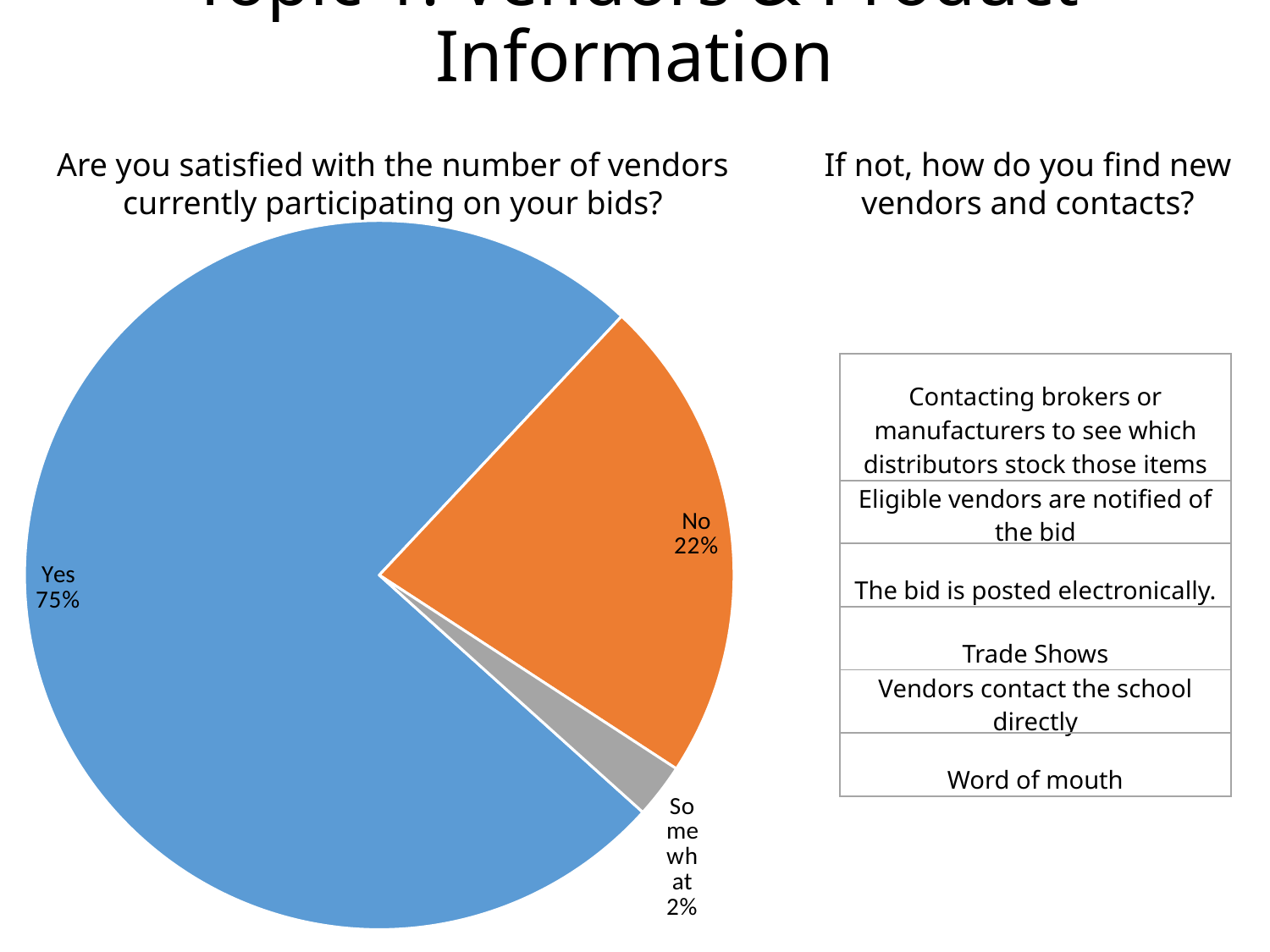
How many slices does the pie chart have? 3 What share of the pie does the "Yes" slice represent? 75% What is the difference in percentage points between the "No" and "Somewhat" slices? 20 What kind of chart is shown on the slide? pie chart What is the difference in percentage points between the "Yes" and "No" slices? 53 Which response has the largest slice of the pie? Yes What colour is the "No" slice of the pie chart? orange What share of the pie does the "No" slice represent? 22% Which response has the smallest slice of the pie? Somewhat What is the title of the pie chart? Are you satisfied with the number of vendors currently participating on your bids? Which slice is larger, "No" or "Somewhat"? No What share of the pie does the "Somewhat" slice represent? 2%